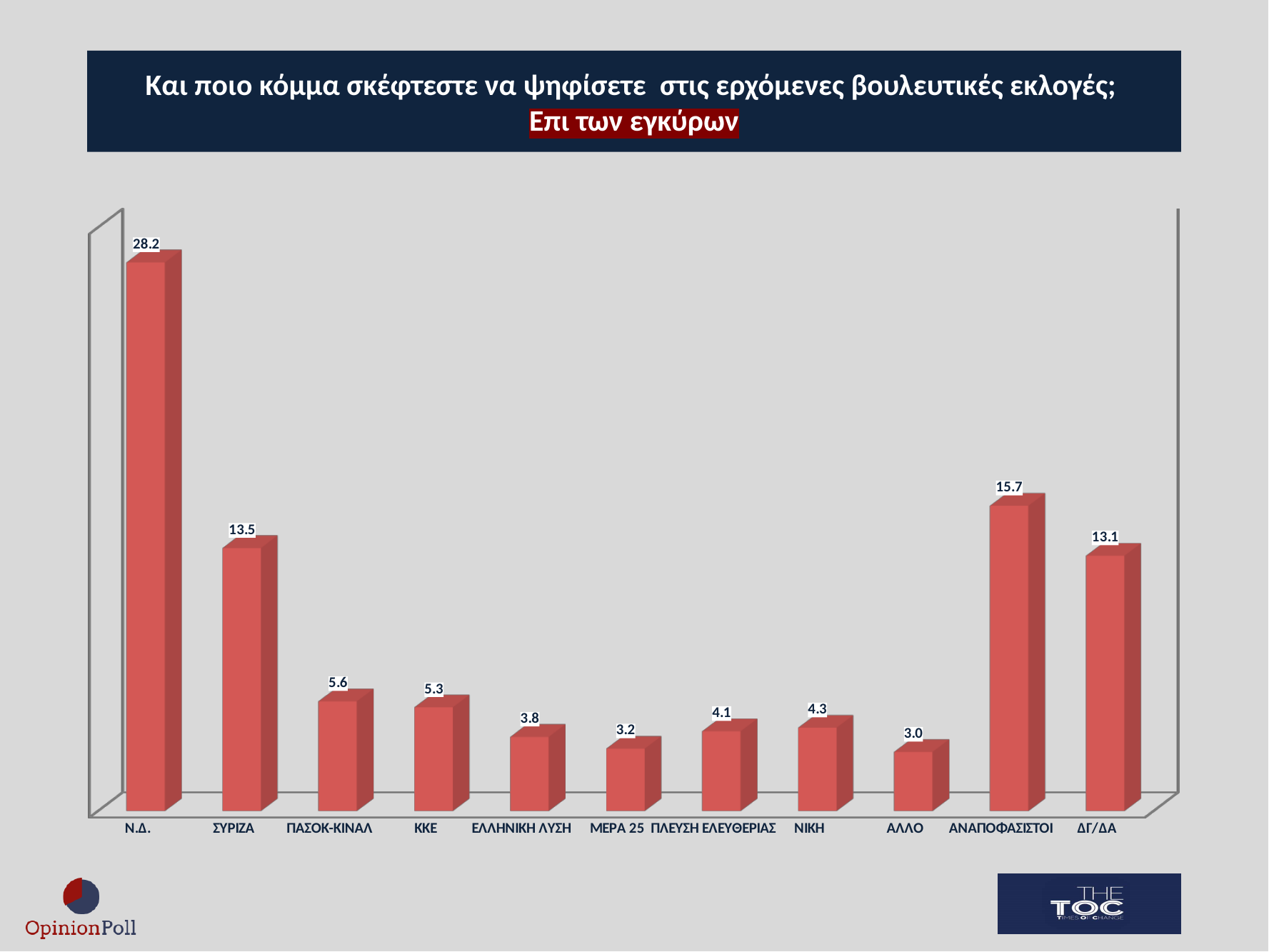
What is the value for ΑΝΑΠΟΦΑΣΙΣΤΟΙ? 15.7 What colour are the bars in the chart? red What kind of chart is shown on the slide? bar chart How many categories are shown on the x axis? 11 What is the value for ΣΥΡΙΖΑ? 13.5 What is the difference between the values for ΑΝΑΠΟΦΑΣΙΣΤΟΙ and ΔΓ/ΔΑ? 2.6 Which category has the highest value? Ν.Δ. What is the difference between the values for Ν.Δ. and ΣΥΡΙΖΑ? 14.7 Which is larger, the value for ΠΑΣΟΚ-ΚΙΝΑΛ or the value for ΚΚΕ? ΠΑΣΟΚ-ΚΙΝΑΛ What is the value for Ν.Δ.? 28.2 What is the value for ΠΛΕΥΣΗ ΕΛΕΥΘΕΡΙΑΣ? 4.1 Which category has the lowest value? ΑΛΛΟ